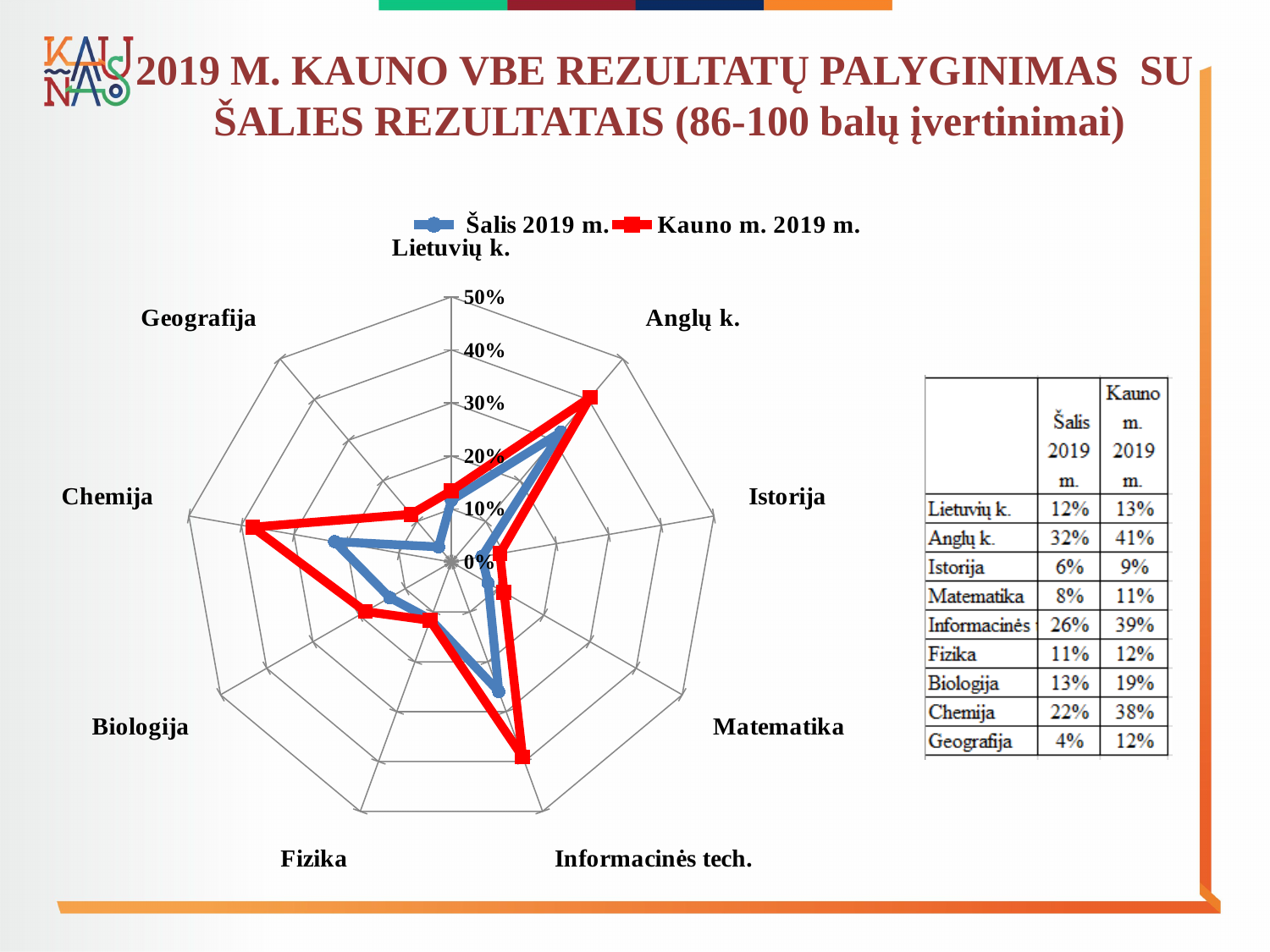
How many series does the chart legend list? 2 What kind of chart is shown on the slide? radar chart Which subject has the highest Kauno m. 2019 m. value? Anglų k. What is the difference between the Kauno m. 2019 m. and Šalis 2019 m. values for Chemija? 16% What colour is the line for the Kauno m. 2019 m. series? red According to the table, what is the Kauno m. 2019 m. value for Anglų k.? 41% Is the Kauno m. 2019 m. value for Anglų k. greater or less than 40%? greater Which subject has the lowest Šalis 2019 m. value? Geografija According to the table, what is the Šalis 2019 m. value for Chemija? 22% Which is larger for Informacinės tech.: the Šalis 2019 m. value or the Kauno m. 2019 m. value? Kauno m. 2019 m. What is the Šalis 2019 m. value for Istorija? 6% How many subjects (categories) are plotted on the radar chart? 9